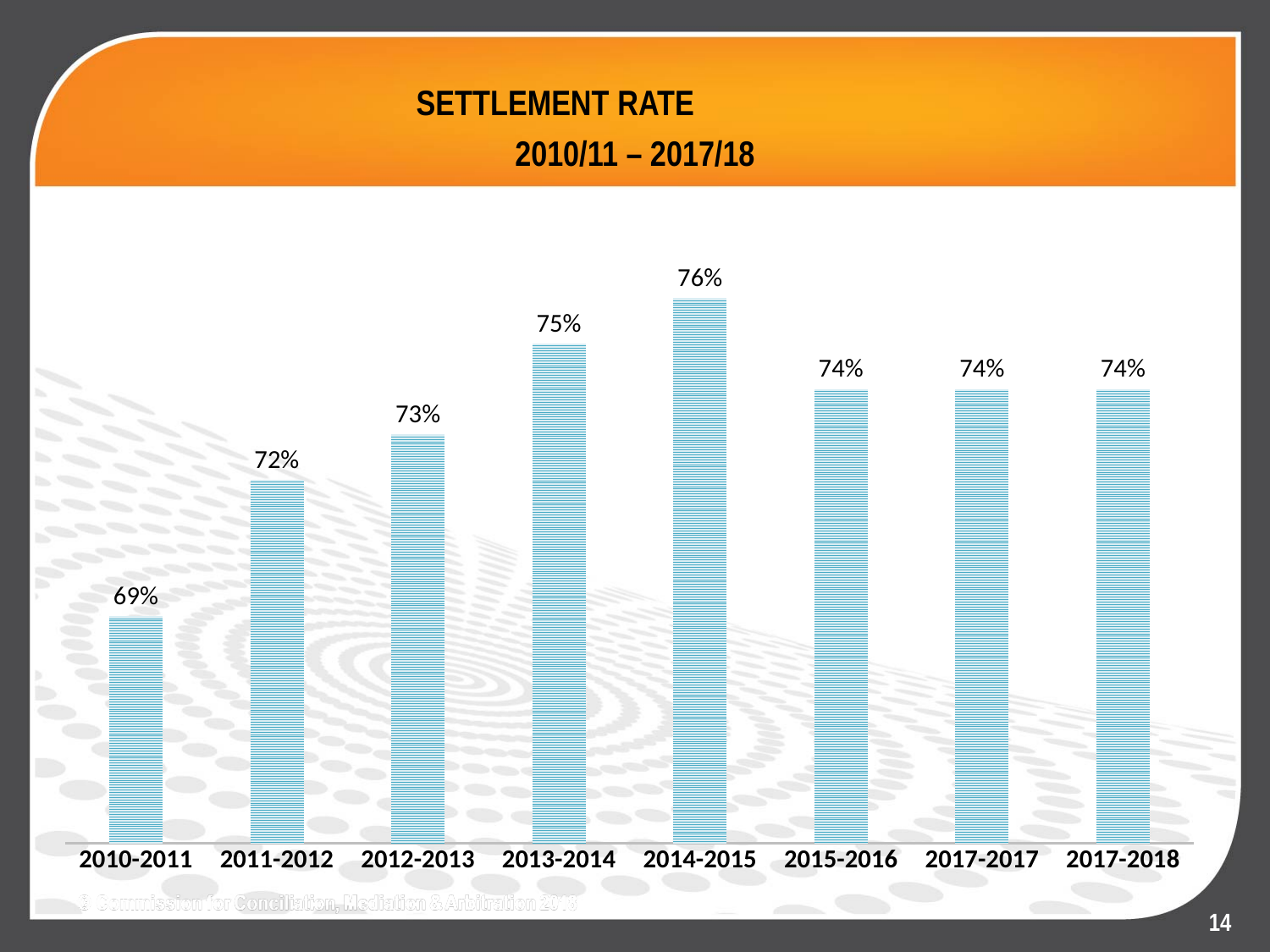
What is the settlement rate for 2010-2011? 69% Does the settlement rate rise or fall from 2010-2011 to 2014-2015? Rise What kind of chart is shown on the slide? Bar chart What is the difference between the settlement rate in 2014-2015 and in 2010-2011? 7% Which period has the highest settlement rate? 2014-2015 What is the title of the chart? SETTLEMENT RATE 2010/11 – 2017/18 What is the settlement rate for 2014-2015? 76% What is the difference between the settlement rate in 2013-2014 and in 2011-2012? 3% What is the settlement rate for 2012-2013? 73% How many periods are shown on the chart? 8 Which period has the lowest settlement rate? 2010-2011 Which is higher, the settlement rate for 2013-2014 or for 2015-2016? 2013-2014